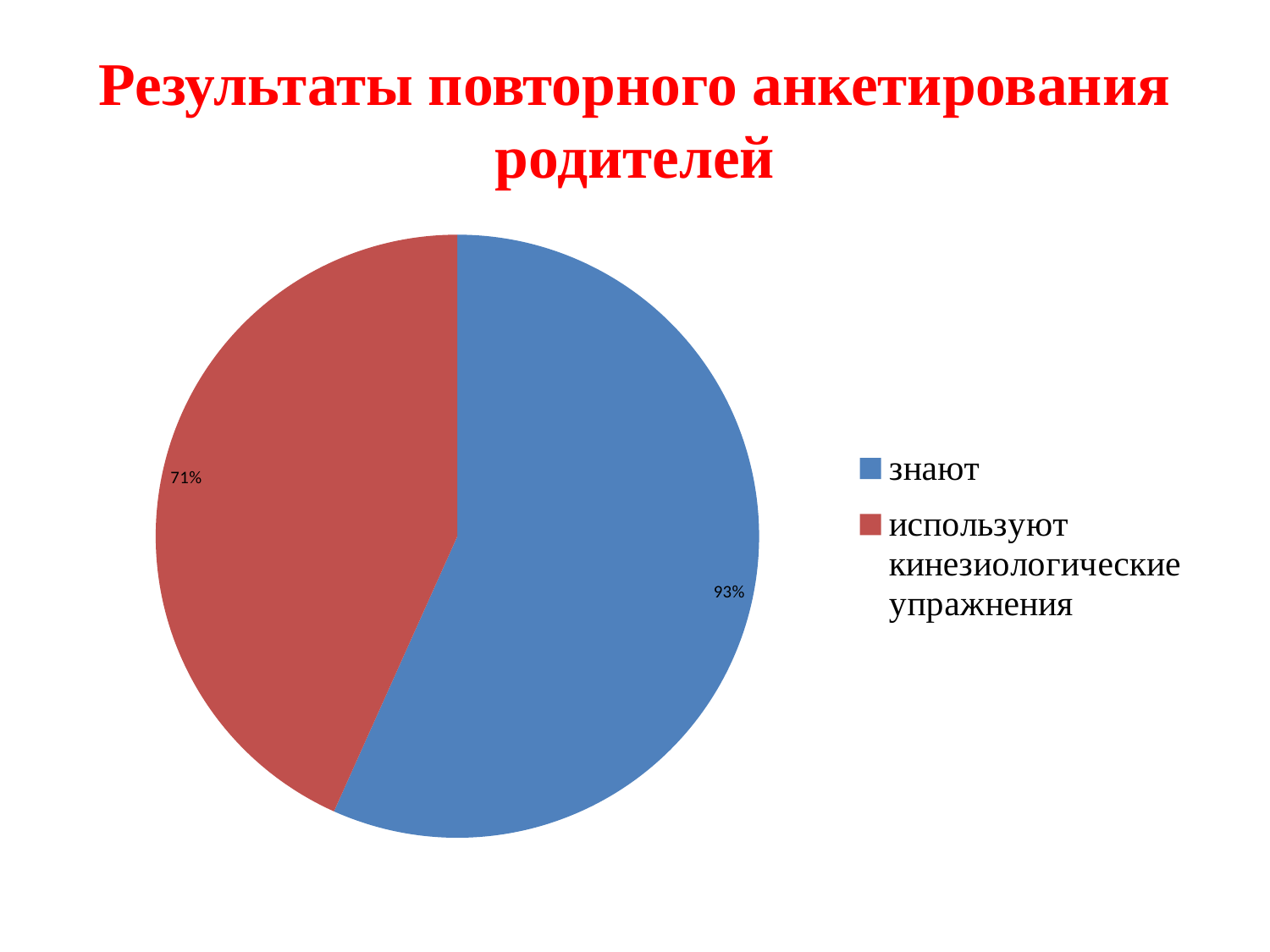
What colour is the "знают" slice in the pie chart? blue What is the title of the slide containing the pie chart? Результаты повторного анкетирования родителей What value is labelled on the "знают" slice of the pie chart? 93% Which category has the larger labelled value in the pie chart? знают Is the labelled value for "знают" larger or smaller than the value for "используют кинезиологические упражнения"? larger How many entries does the legend of the pie chart list? 2 Which category has the smaller labelled value in the pie chart? используют кинезиологические упражнения What value is labelled on the "используют кинезиологические упражнения" slice of the pie chart? 71% What type of chart is shown on the slide? pie chart How many slices does the pie chart have? 2 What is the difference between the labelled values for "знают" and "используют кинезиологические упражнения"? 22%